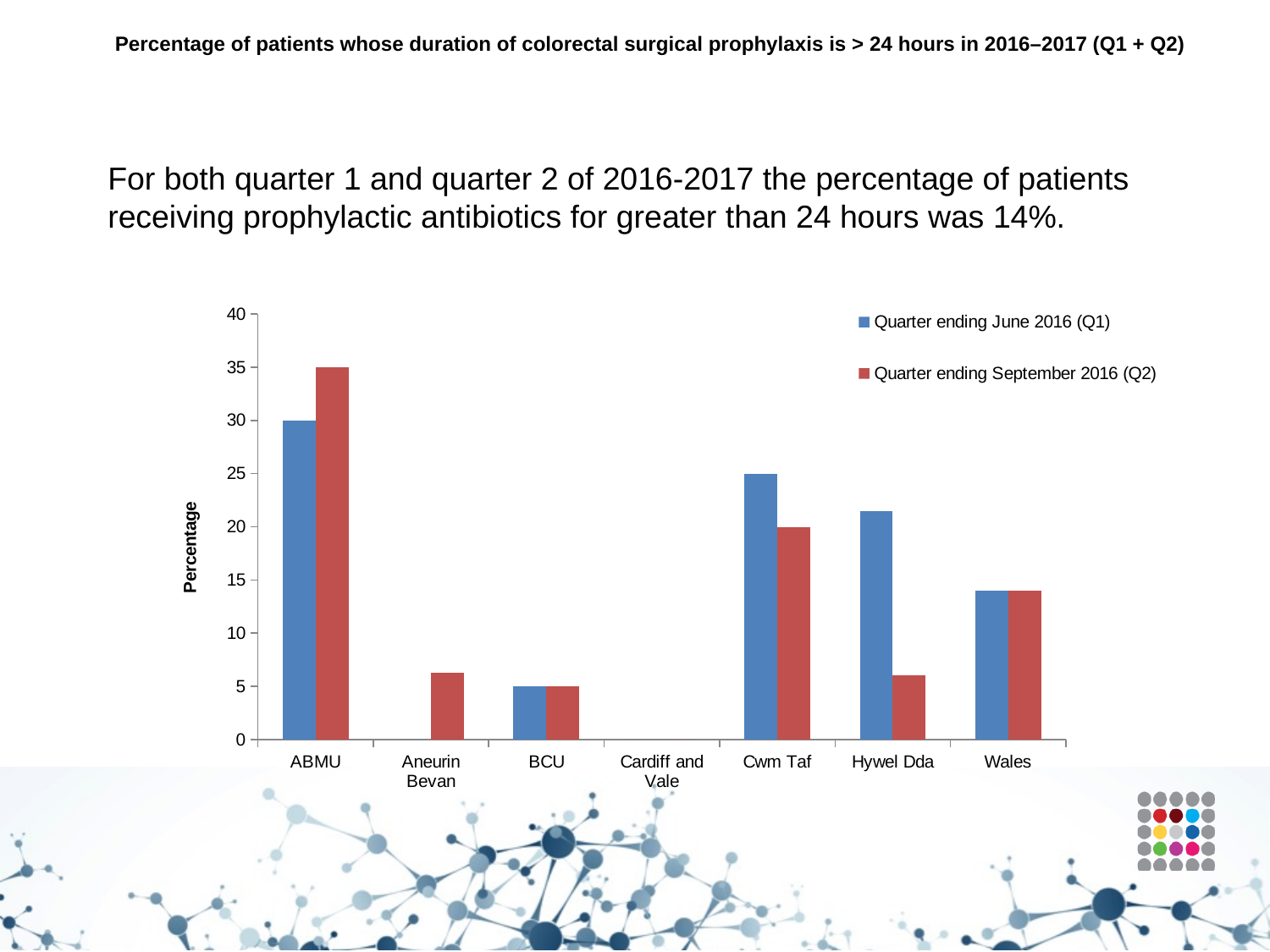
What kind of chart is shown on the slide? bar chart What is the difference between the Q2 and Q1 values for ABMU? 5 How many series does the legend list? 2 For Cwm Taf, which is larger: the Q1 value or the Q2 value? Q1 What is the value for Cwm Taf in the Quarter ending June 2016 (Q1) series? 25 How many categories are shown on the x axis? 7 Which category has the highest value in the Quarter ending September 2016 (Q2) series? ABMU What is the value for ABMU in the Quarter ending September 2016 (Q2) series? 35 What is the label on the y axis of the chart? Percentage Is the value for Hywel Dda in the Quarter ending June 2016 (Q1) series greater or less than 20? greater Is the value for Aneurin Bevan in the Quarter ending September 2016 (Q2) series greater or less than 10? less What is the value for Cwm Taf in the Quarter ending September 2016 (Q2) series? 20